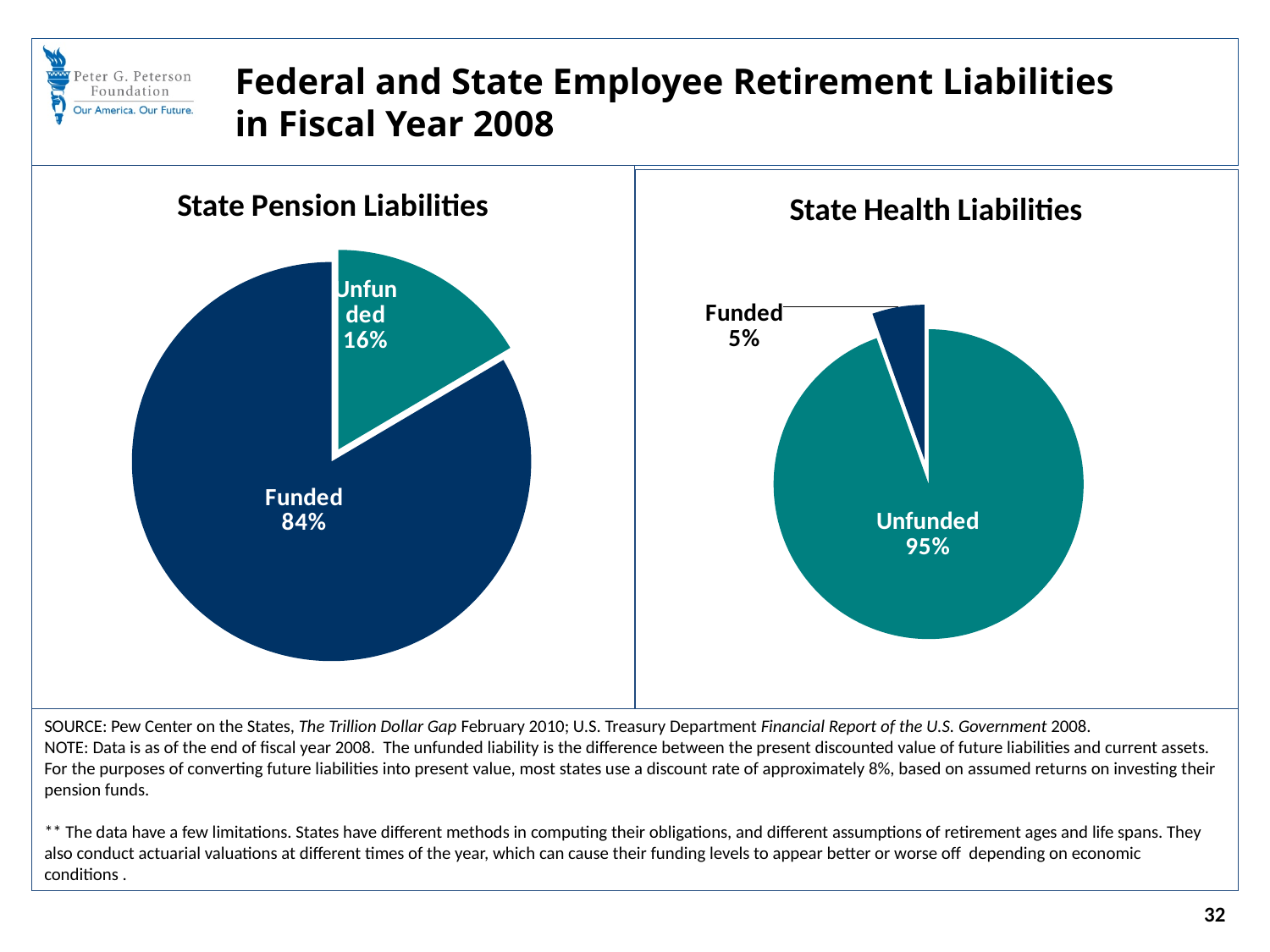
In the State Health Liabilities chart, what share is Funded? 5% In the State Pension Liabilities chart, what is the difference between the Funded and Unfunded shares? 68% What kind of chart is the State Health Liabilities chart? Pie chart In the State Pension Liabilities chart, what share is Funded? 84% What is the title of the chart on the left side of the slide? State Pension Liabilities In the State Pension Liabilities chart, which slice is the largest? Funded In the State Health Liabilities chart, which slice is the smallest? Funded In the State Pension Liabilities chart, what share is Unfunded? 16% Is the Funded share larger in the State Pension Liabilities chart or the State Health Liabilities chart? State Pension Liabilities How many slices does the State Pension Liabilities pie chart have? 2 In the State Health Liabilities chart, what is the difference between the Unfunded and Funded shares? 90%